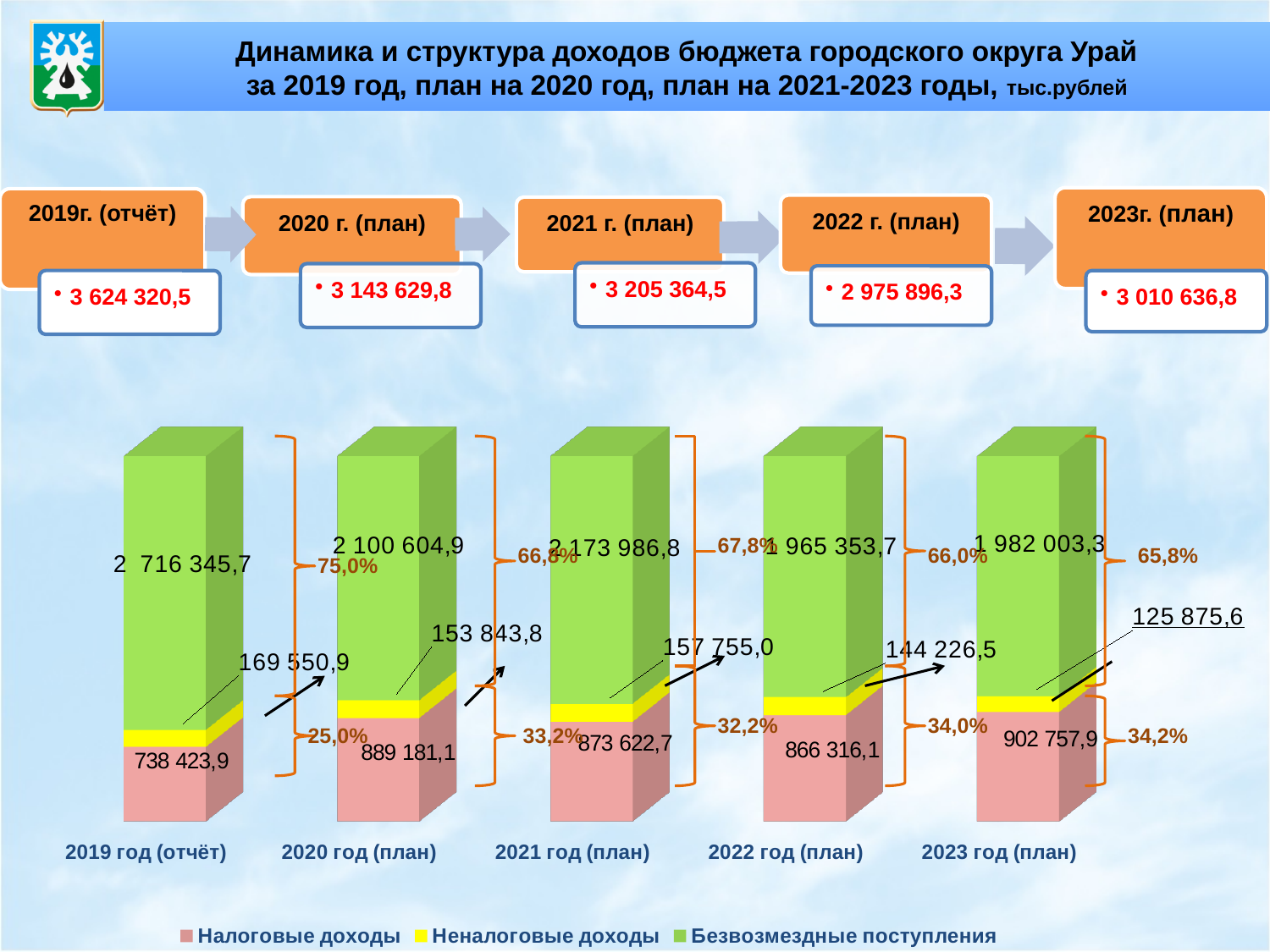
What is the value of Безвозмездные поступления for 2022 год (план)? 1 965 353,7 What is the value of Неналоговые доходы for 2021 год (план)? 157 755,0 What is the difference between Безвозмездные поступления in 2019 год (отчёт) and in 2020 год (план)? 615 740,8 Which is larger: Налоговые доходы in 2020 год (план) or in 2021 год (план)? 2020 год (план) What kind of chart is shown on the slide? Stacked bar chart In which year is the value of Неналоговые доходы the lowest? 2023 год (план) What is the value of Безвозмездные поступления for 2019 год (отчёт)? 2 716 345,7 What is the total of the stacked bar for 2019 год (отчёт)? 3 624 320,5 How many series does the legend list? 3 How many years (categories) are shown on the chart? 5 What is the value of Налоговые доходы for 2023 год (план)? 902 757,9 In which year is the value of Безвозмездные поступления the highest? 2019 год (отчёт)